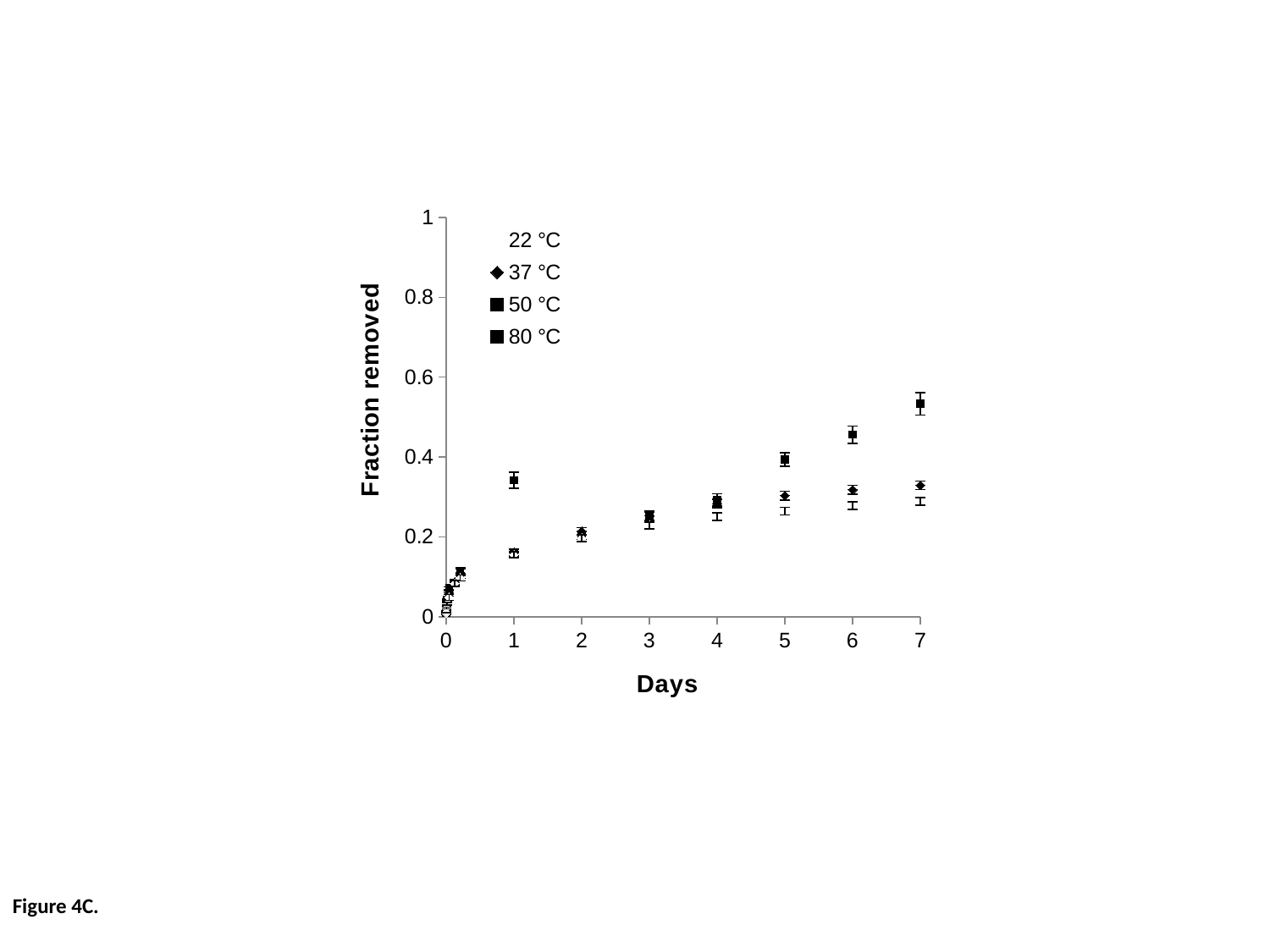
At day 2, are the plotted values greater or less than 0.4? less At day 7, is the lowest plotted value greater or less than 0.2? greater Do the plotted values generally rise or fall as the number of days increases? rise What is the maximum value shown on the y axis? 1 At day 7, is the highest plotted value greater or less than 0.4? greater What is the title of the y axis? Fraction removed What is the title of the x axis? Days How many series does the legend list? 4 What kind of chart is shown on the slide? scatter chart How many tick labels are shown on the x axis? 8